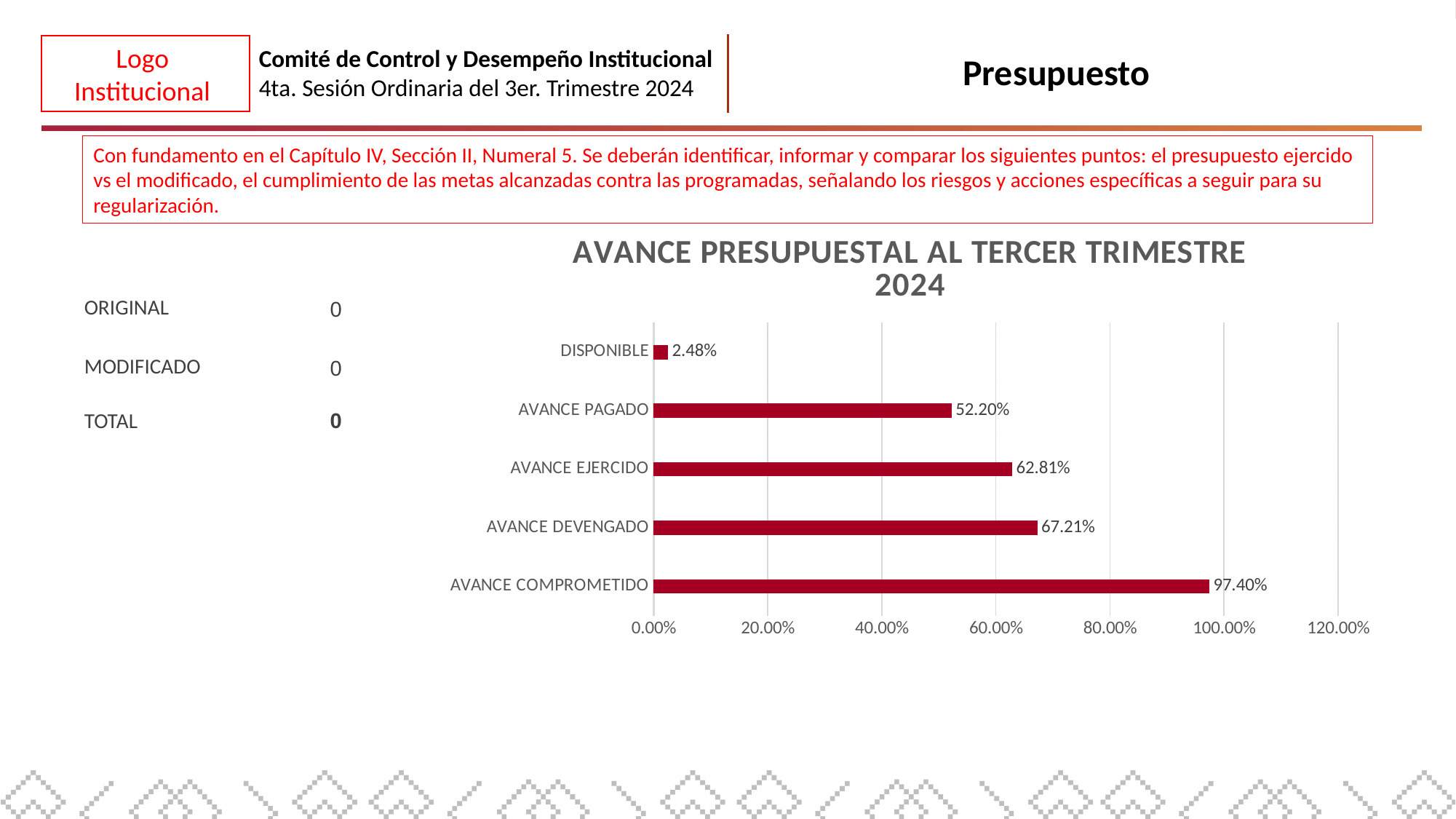
What kind of chart is shown? Bar chart Which category has the lowest value? DISPONIBLE What is the value for AVANCE EJERCIDO? 62.81% What is the value for AVANCE PAGADO? 52.20% Which is larger, AVANCE EJERCIDO or AVANCE PAGADO? AVANCE EJERCIDO What is the title of the chart? AVANCE PRESUPUESTAL AL TERCER TRIMESTRE 2024 What is the value for AVANCE DEVENGADO? 67.21% Which category has the highest value? AVANCE COMPROMETIDO What is the value for DISPONIBLE? 2.48% What is the value for AVANCE COMPROMETIDO? 97.40% How many categories are shown in the chart? 5 What is the difference between AVANCE COMPROMETIDO and AVANCE DEVENGADO? 30.19%